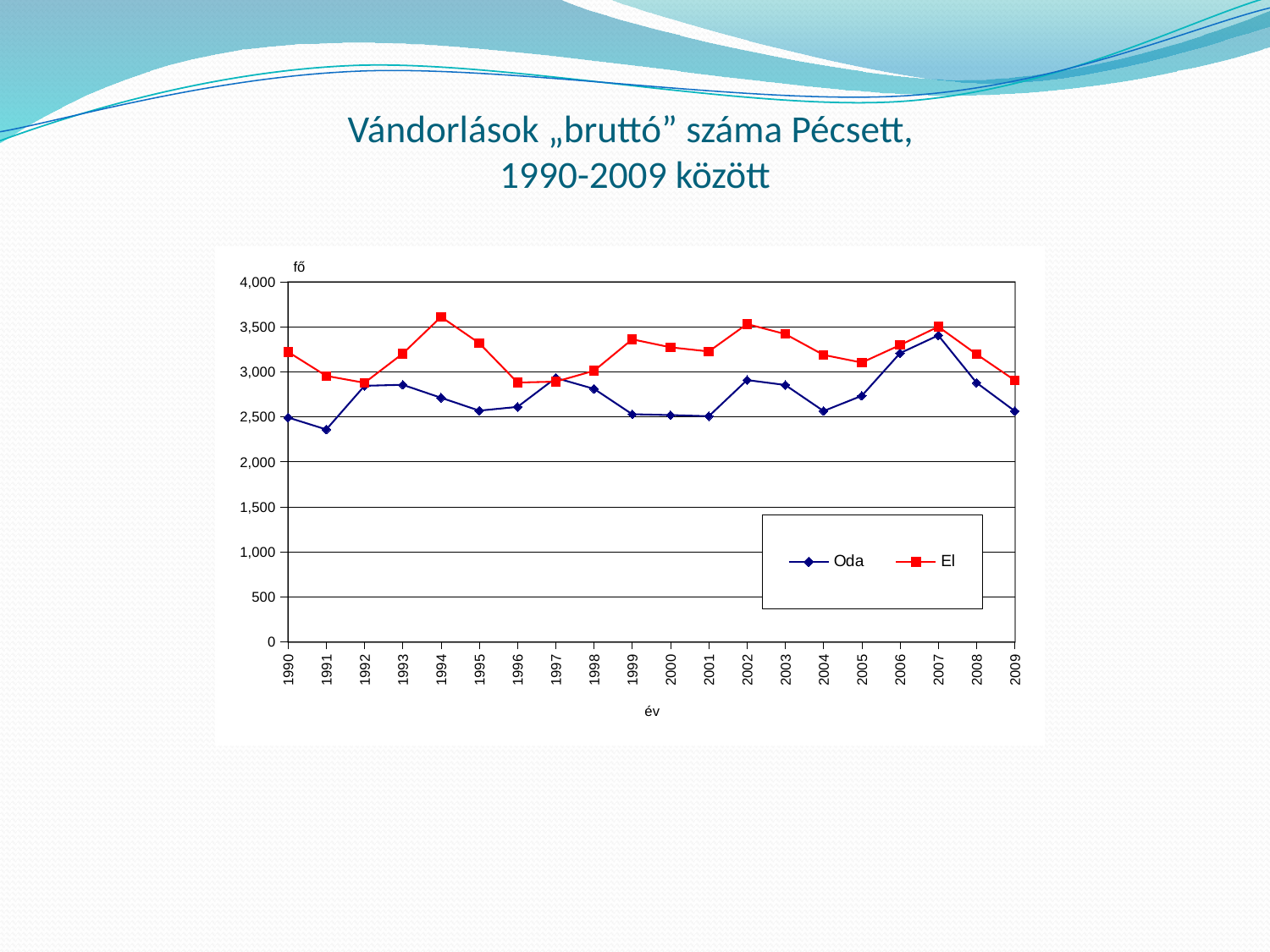
How many years are plotted along the x axis? 20 In which year does the Oda series reach its highest value? 2007 In which year does the Oda series reach its lowest value? 1991 Is the value for El in 1996 greater or less than 3,000? less What kind of chart is shown on the slide? line chart Does the Oda series rise or fall from 2004 to 2007? rise How many series does the legend list? 2 Is the value for Oda in 1991 greater or less than 2,500? less In 1999, which series has the larger value, Oda or El? El What label is shown on the x axis? év Is the value for El in 1994 greater or less than 3,500? greater In which year does the El series reach its highest value? 1994